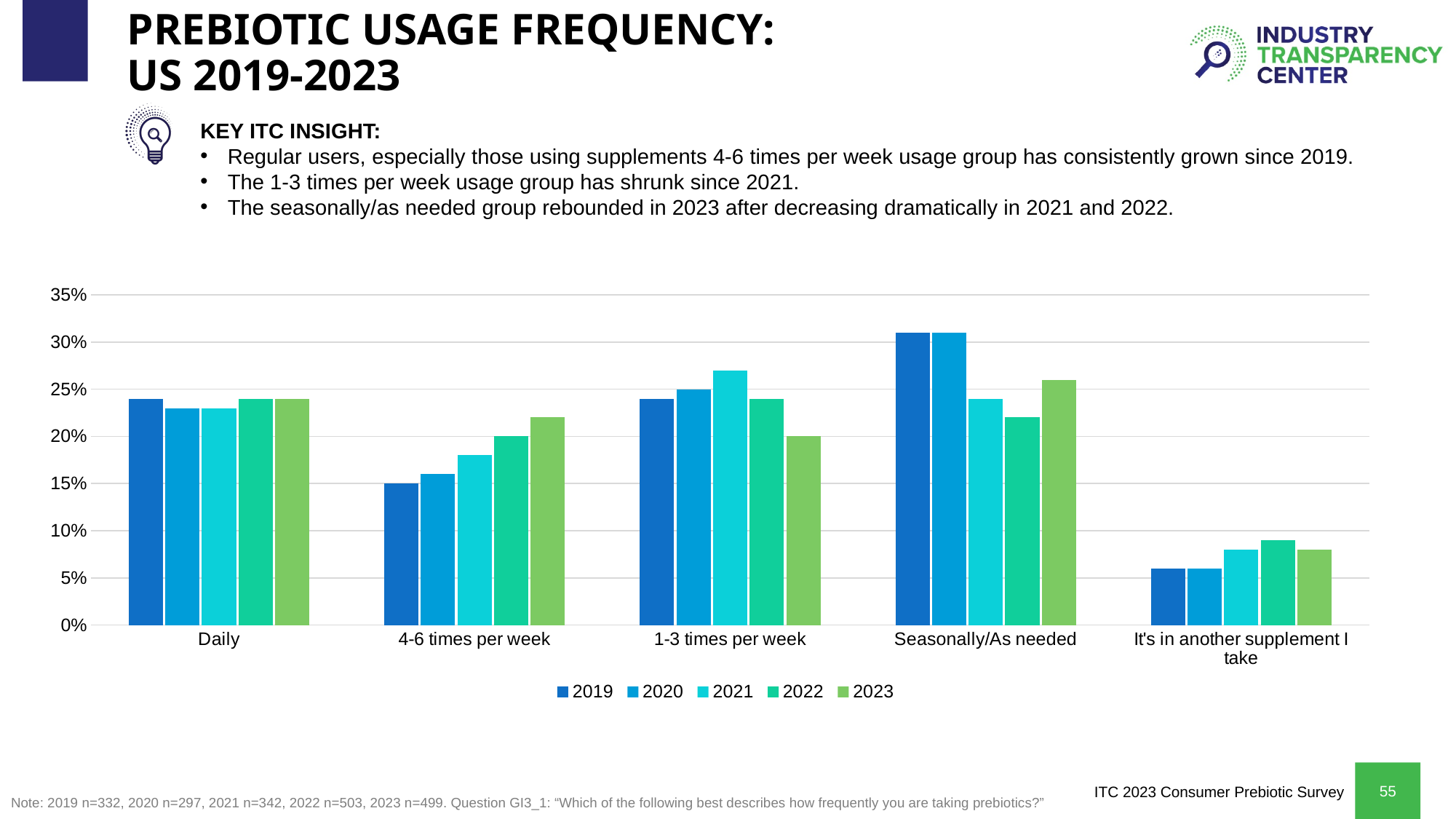
Is the 2021 value for 1-3 times per week greater or less than 25%? greater How many series does the legend list? 5 Is the 2019 value for Seasonally/As needed greater or less than 30%? greater How many usage frequency categories are shown on the x axis? 5 Which category has the highest 2019 value? Seasonally/As needed Which category has the lowest 2023 value? It's in another supplement I take What kind of chart is shown on the slide? bar chart For Seasonally/As needed, which year has the larger value, 2022 or 2023? 2023 Is the 2021 value for Daily greater or less than 25%? less Do the values for 4-6 times per week rise or fall from 2019 to 2023? rise